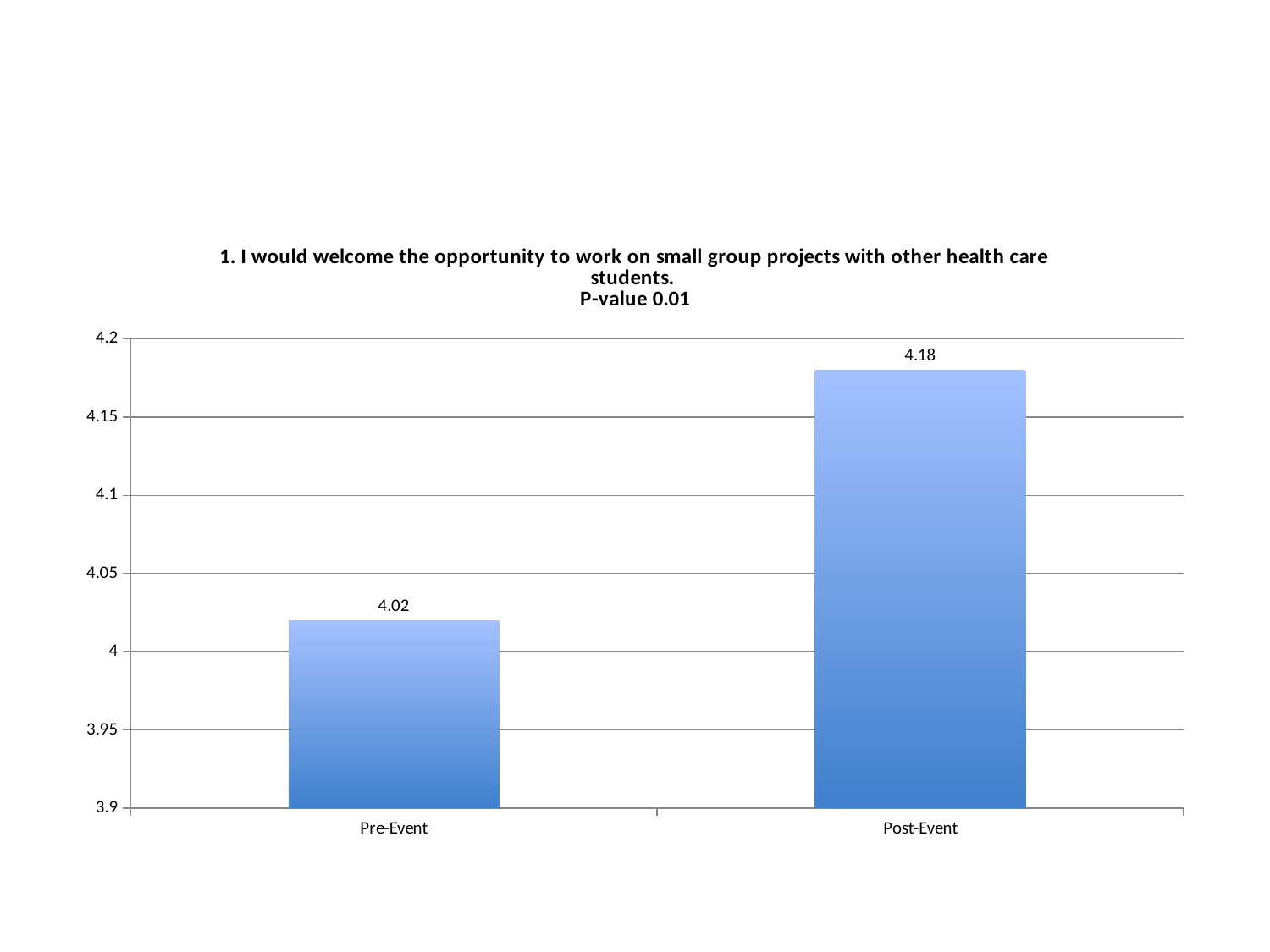
Do the values rise or fall from Pre-Event to Post-Event? rise What is the difference between the Post-Event and Pre-Event values? 0.16 What is the value for Post-Event? 4.18 What kind of chart is shown on the slide? bar chart How many categories are shown on the x axis? 2 What is the value for Pre-Event? 4.02 Is the value for Post-Event greater or less than 4.15? greater Which category has the lowest value? Pre-Event What P-value is stated in the chart title? 0.01 Which is larger, the Pre-Event value or the Post-Event value? Post-Event Which category has the highest value? Post-Event Is the value for Pre-Event greater or less than 4.05? less